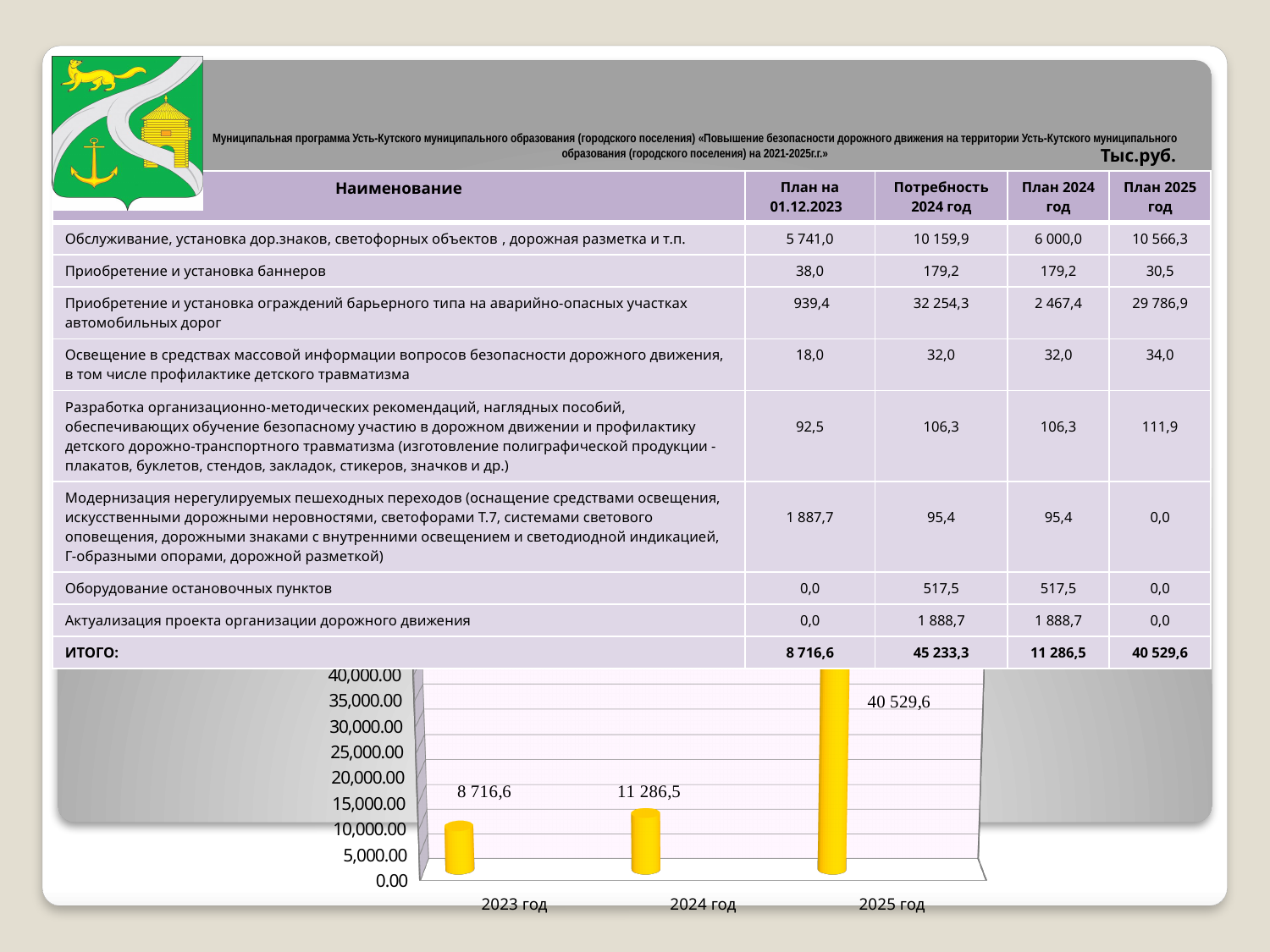
Which year has the lowest value in the chart? 2023 год What is the value shown for 2024 год in the chart? 11 286,5 Is the value for 2025 год in the chart greater or less than 35,000.00? greater Which is larger in the chart, the value for 2024 год or the value for 2023 год? 2024 год What kind of chart is shown at the bottom of the slide? bar chart How many categories are plotted on the x axis of the chart? 3 Do the values in the chart rise or fall from 2023 год to 2025 год? rise What is the difference between the values for 2024 год and 2023 год in the chart? 2 569,9 Which year has the highest value in the chart? 2025 год What is the difference between the values for 2025 год and 2024 год in the chart? 29 243,1 What is the value shown for 2025 год in the chart? 40 529,6 What is the value shown for 2023 год in the chart? 8 716,6